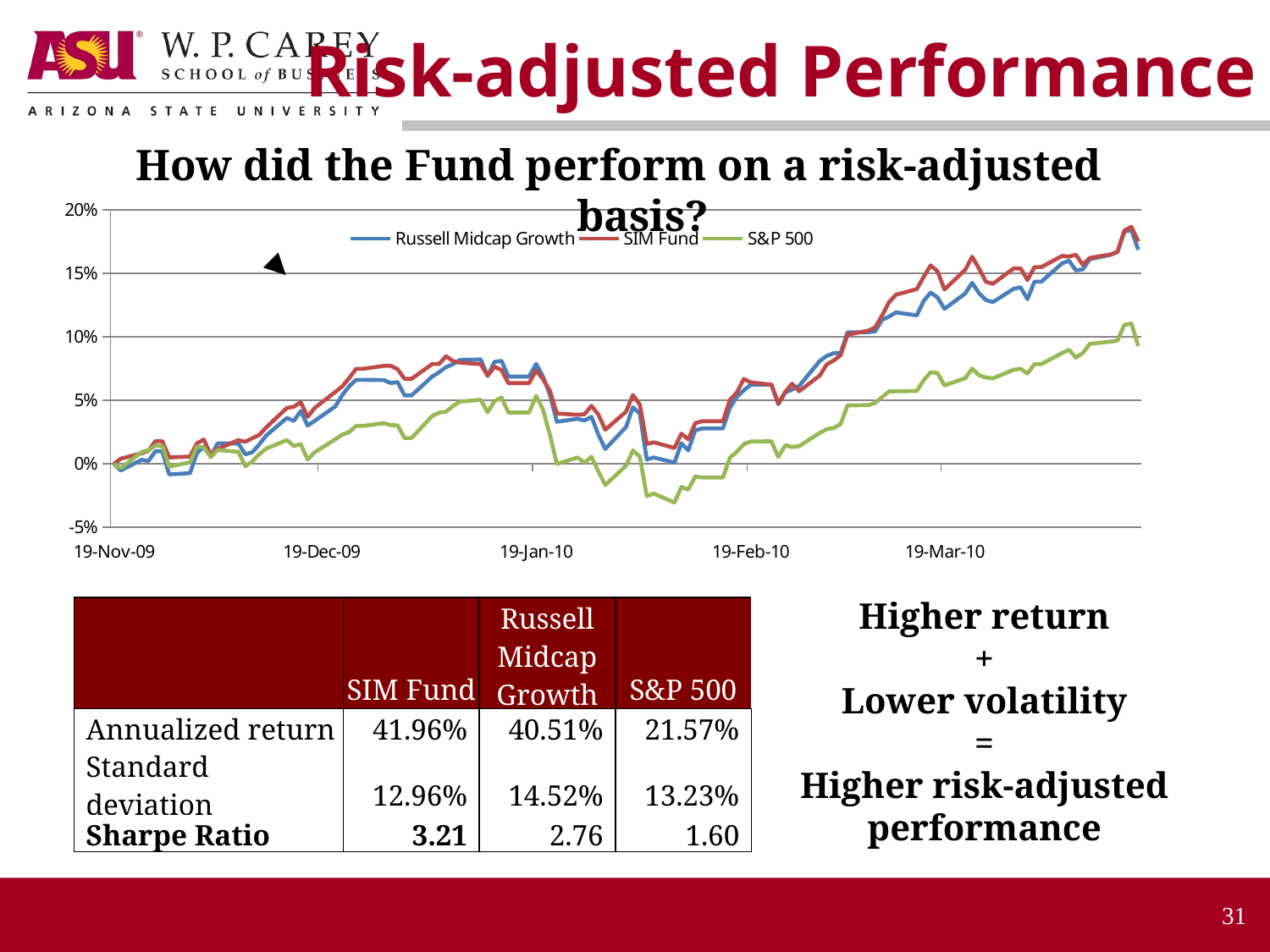
Which series is lowest at 19-Mar-10? S&P 500 Is the value for Russell Midcap Growth at 19-Jan-10 greater or less than 5%? greater Overall, does the S&P 500 line rise or fall from 19-Nov-09 to the end of the chart? rise At the right-hand end of the chart, which is higher, the SIM Fund or the S&P 500? SIM Fund Which three series are listed in the chart's legend? Russell Midcap Growth, SIM Fund, S&P 500 What kind of chart is shown on the slide? line chart What is the lowest value shown on the chart's y axis? -5% Does the S&P 500 line fall below 0% at any point on the chart? yes Is the value for the S&P 500 at 19-Feb-10 greater or less than 5%? less How many date labels are shown on the chart's x axis? 5 How many series does the chart's legend list? 3